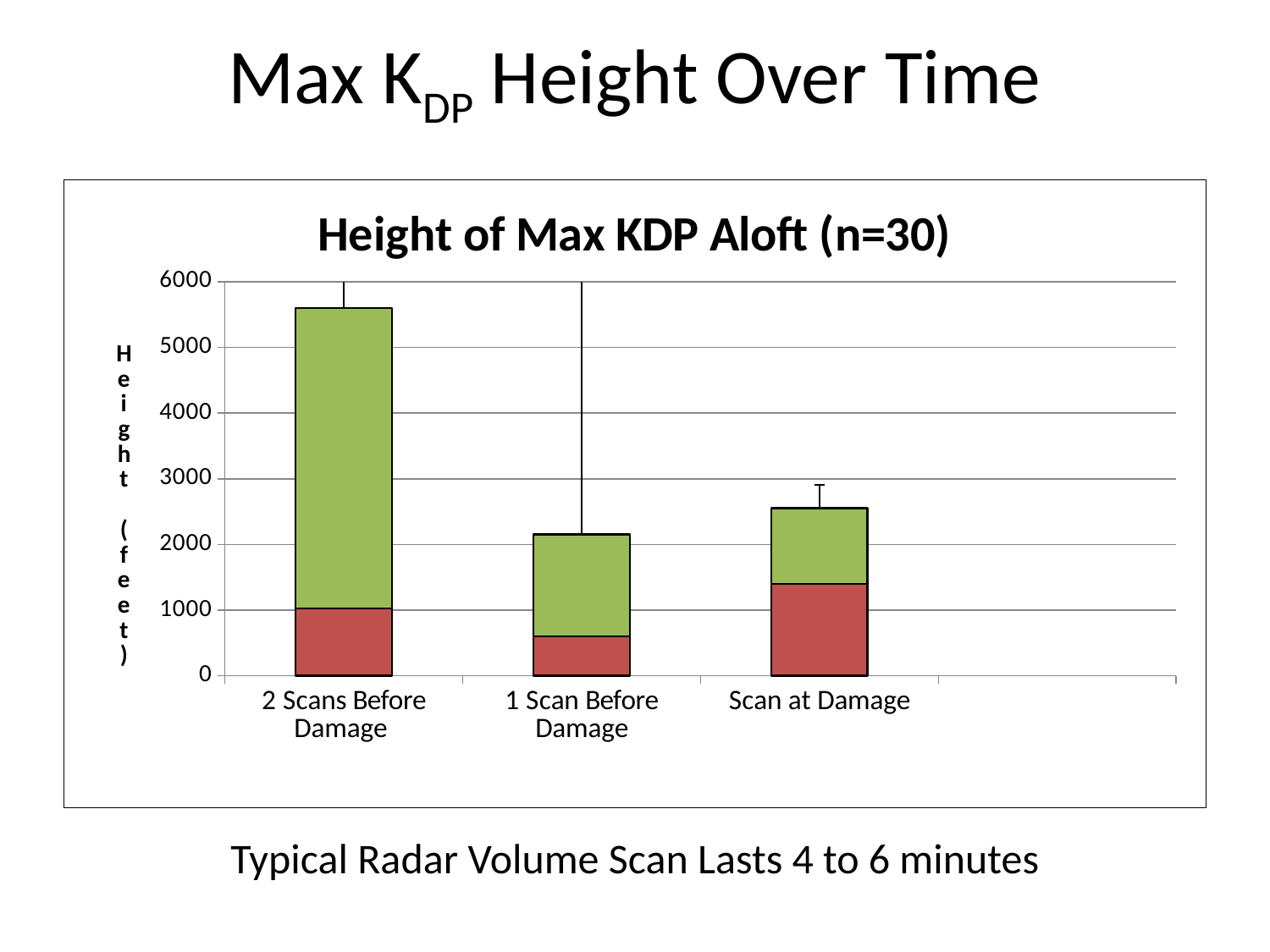
Does the total bar height rise or fall from 2 Scans Before Damage to 1 Scan Before Damage? fall Is the total bar height for 1 Scan Before Damage greater or less than 3000? less What kind of chart is shown on the slide? bar chart Is the total bar height for 2 Scans Before Damage greater or less than 5000? greater Is the total bar height for Scan at Damage greater or less than 2000? greater Which has the taller total bar, 1 Scan Before Damage or Scan at Damage? Scan at Damage Which category has the tallest total bar? 2 Scans Before Damage How many categories are shown on the x axis of the chart? 3 What is the title of the chart? Height of Max KDP Aloft (n=30) Which category has the shortest total bar? 1 Scan Before Damage What is the label on the vertical axis of the chart? Height (feet)